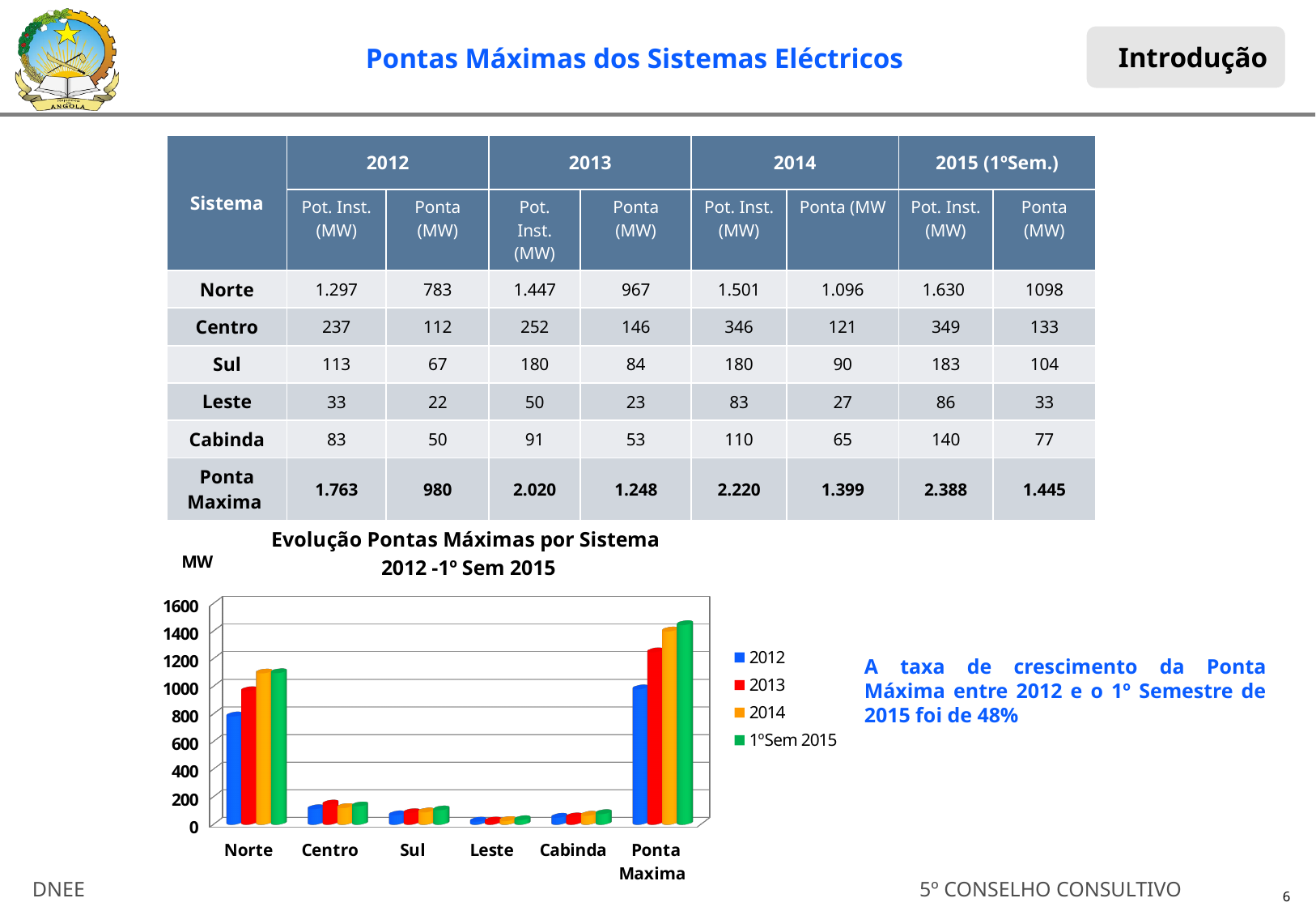
Do the values for Ponta Maxima rise or fall from 2012 to 1ºSem 2015? rise Which category has the highest value in the 2012 series? Ponta Maxima Which legend entry is shown in green? 1ºSem 2015 How many series does the chart legend list? 4 Which category has the lowest value in the 2014 series? Leste What is the title of the chart? Evolução Pontas Máximas por Sistema 2012 -1º Sem 2015 Is the value for Centro in 2013 greater or less than 200? less What kind of chart is shown on the slide? bar chart How many categories are shown on the x axis of the chart? 6 Which is larger in the 2013 series, Centro or Sul? Centro Is the value for Norte in 2012 greater or less than 600? greater Is the value for Ponta Maxima in 2014 greater or less than 1200? greater